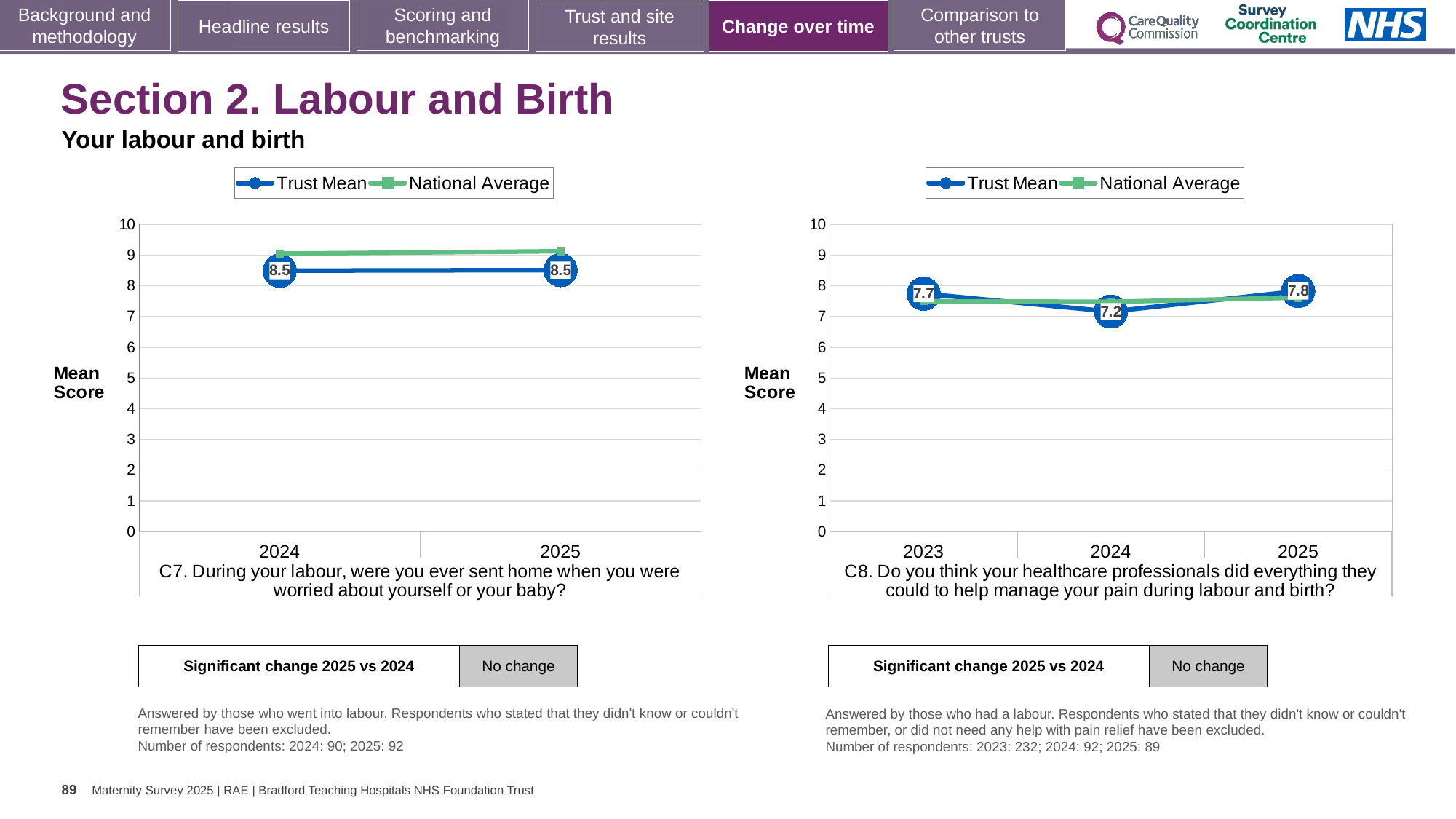
What kind of chart is the C8 chart on the right? Line chart In the C7 chart on the left, what is the Trust Mean score for 2024? 8.5 In the C8 chart on the right, which year has the highest Trust Mean score? 2025 In the C8 chart on the right, what is the difference between the Trust Mean scores for 2025 and 2024? 0.6 In the C8 chart on the right, which year has the lowest Trust Mean score? 2024 In the C8 chart on the right, what is the Trust Mean score for 2024? 7.2 In the C8 chart on the right, what is the Trust Mean score for 2025? 7.8 How many series does the legend of the C7 chart on the left list? 2 How many years are plotted in the C8 chart on the right? 3 In the C7 chart on the left, what is the Trust Mean score for 2025? 8.5 In the C7 chart on the left, is the National Average for 2025 greater or less than 8? greater In the C7 chart on the left, which is higher in 2024, the Trust Mean or the National Average? National Average